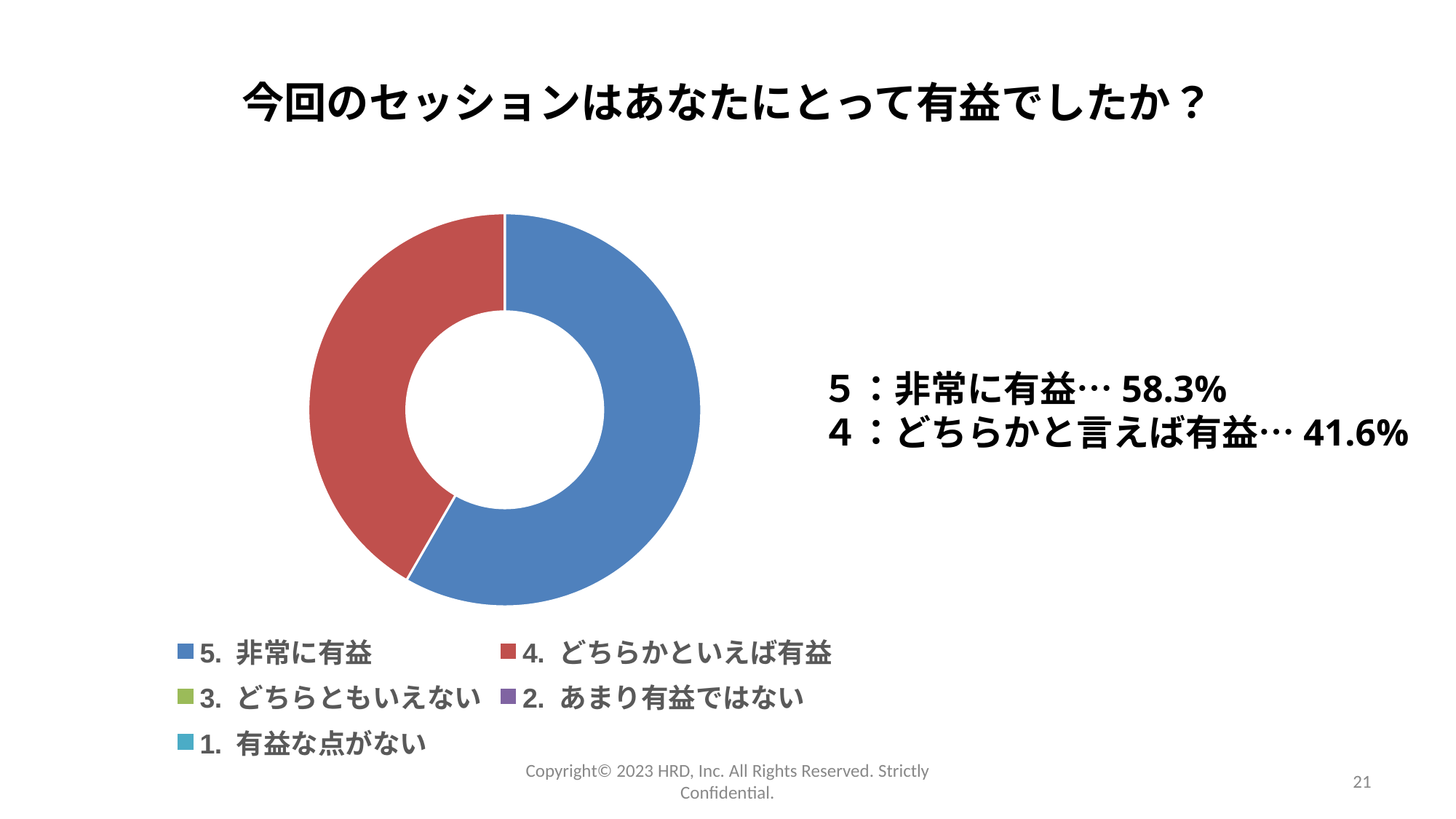
What colour represents "4. どちらかといえば有益" in the chart? Red Which of the two plotted categories has the smaller share, "5. 非常に有益" or "4. どちらかといえば有益"? 4. どちらかといえば有益 How many categories does the legend list? 5 What share of responses is "5. 非常に有益"? 58.3% Which response category has the largest share of the chart? 5. 非常に有益 What kind of chart is shown on the slide? Doughnut (pie) chart Which is larger, the share for "5. 非常に有益" or the share for "4. どちらかといえば有益"? 5. 非常に有益 What is the title of the chart? 今回のセッションはあなたにとって有益でしたか？ Is the share for "5. 非常に有益" greater or less than 50%? greater What is the difference between the share for "5. 非常に有益" and the share for "4. どちらかといえば有益"? 16.7% What share of responses is "4. どちらかといえば有益"? 41.6% How many slices are visible in the doughnut chart? 2